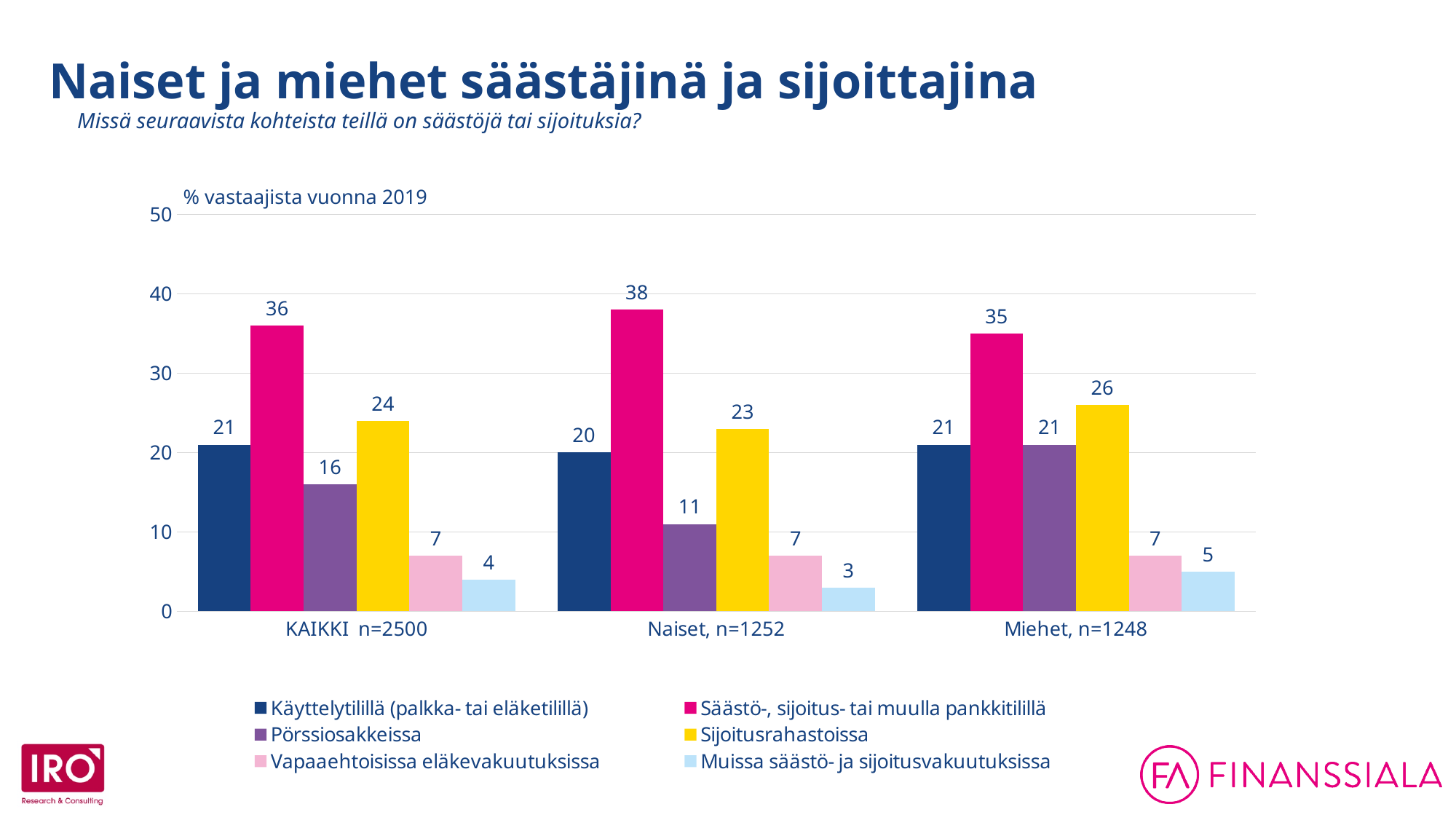
Which is larger: Säästö-, sijoitus- tai muulla pankkitilillä for Naiset, n=1252 or for Miehet, n=1248? Naiset, n=1252 What is the difference between the Pörssiosakkeissa values for Miehet, n=1248 and Naiset, n=1252? 10 What kind of chart is shown on the slide? bar chart Which series has the lowest value in the Miehet, n=1248 group? Muissa säästö- ja sijoitusvakuutuksissa What is the value for Pörssiosakkeissa in the Naiset, n=1252 group? 11 Is the value for Sijoitusrahastoissa in the KAIKKI n=2500 group greater or less than 20? greater What is the value for Säästö-, sijoitus- tai muulla pankkitilillä in the KAIKKI n=2500 group? 36 Which series has the highest value in the Naiset, n=1252 group? Säästö-, sijoitus- tai muulla pankkitilillä What is the value for Sijoitusrahastoissa in the Miehet, n=1248 group? 26 How many groups are shown on the x axis? 3 How many series does the legend list? 6 What is the title of the slide? Naiset ja miehet säästäjinä ja sijoittajina